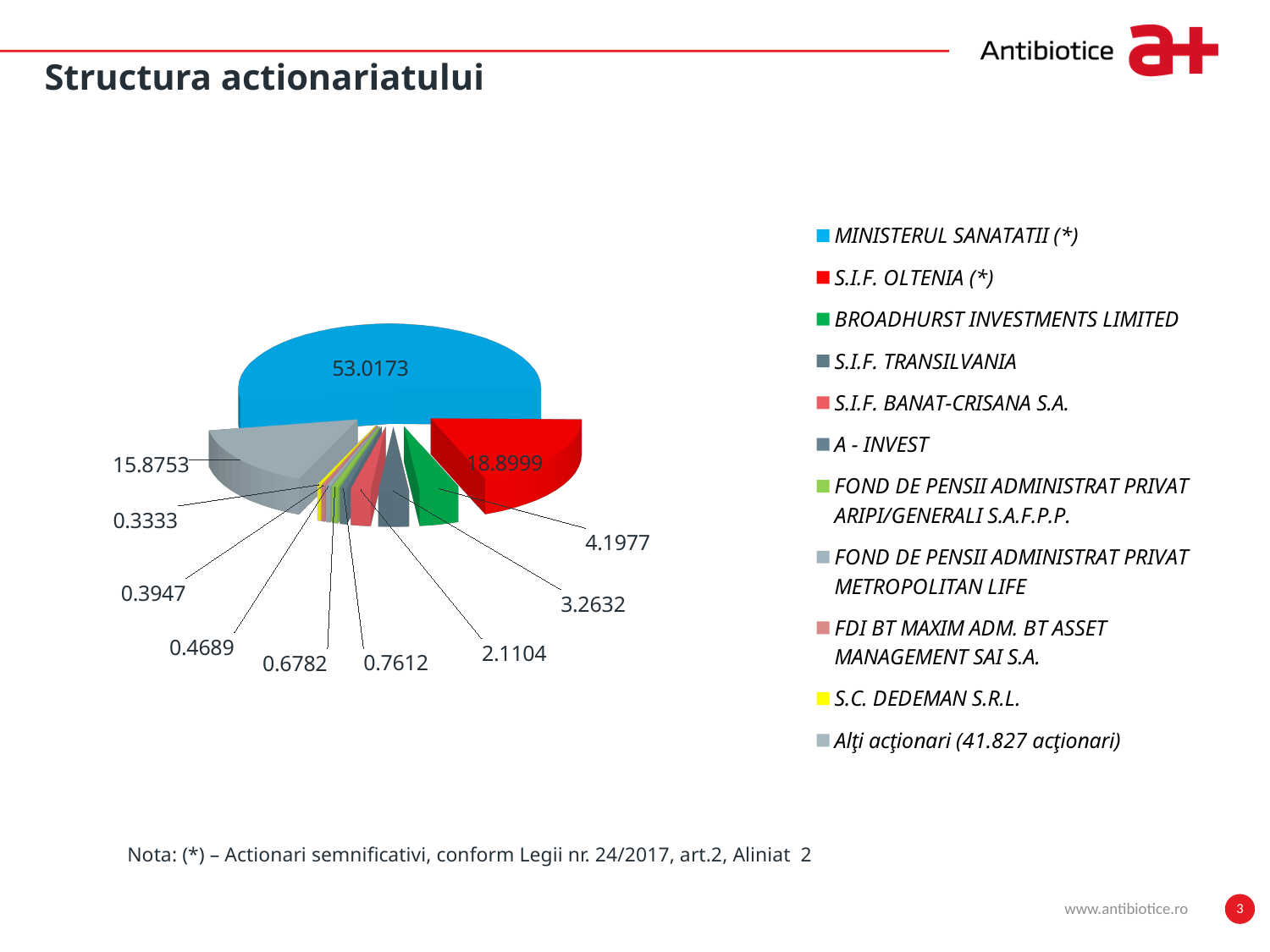
Which is larger, the slice for S.I.F. OLTENIA (*) or the slice for Alţi acţionari (41.827 acţionari)? S.I.F. OLTENIA (*) What kind of chart is shown on the slide? pie chart What is the title of the slide containing the chart? Structura actionariatului What is the smallest value labelled on the pie chart? 0.3333 What is the value shown for S.I.F. OLTENIA (*)? 18.8999 What is the difference between the values for MINISTERUL SANATATII (*) and S.I.F. OLTENIA (*)? 34.1174 How many entries does the legend list? 11 What is the value shown for BROADHURST INVESTMENTS LIMITED? 4.1977 What is the value shown for MINISTERUL SANATATII (*)? 53.0173 What is the value shown for Alţi acţionari (41.827 acţionari)? 15.8753 How many slices does the pie chart have? 11 Which shareholder has the largest slice of the pie? MINISTERUL SANATATII (*)